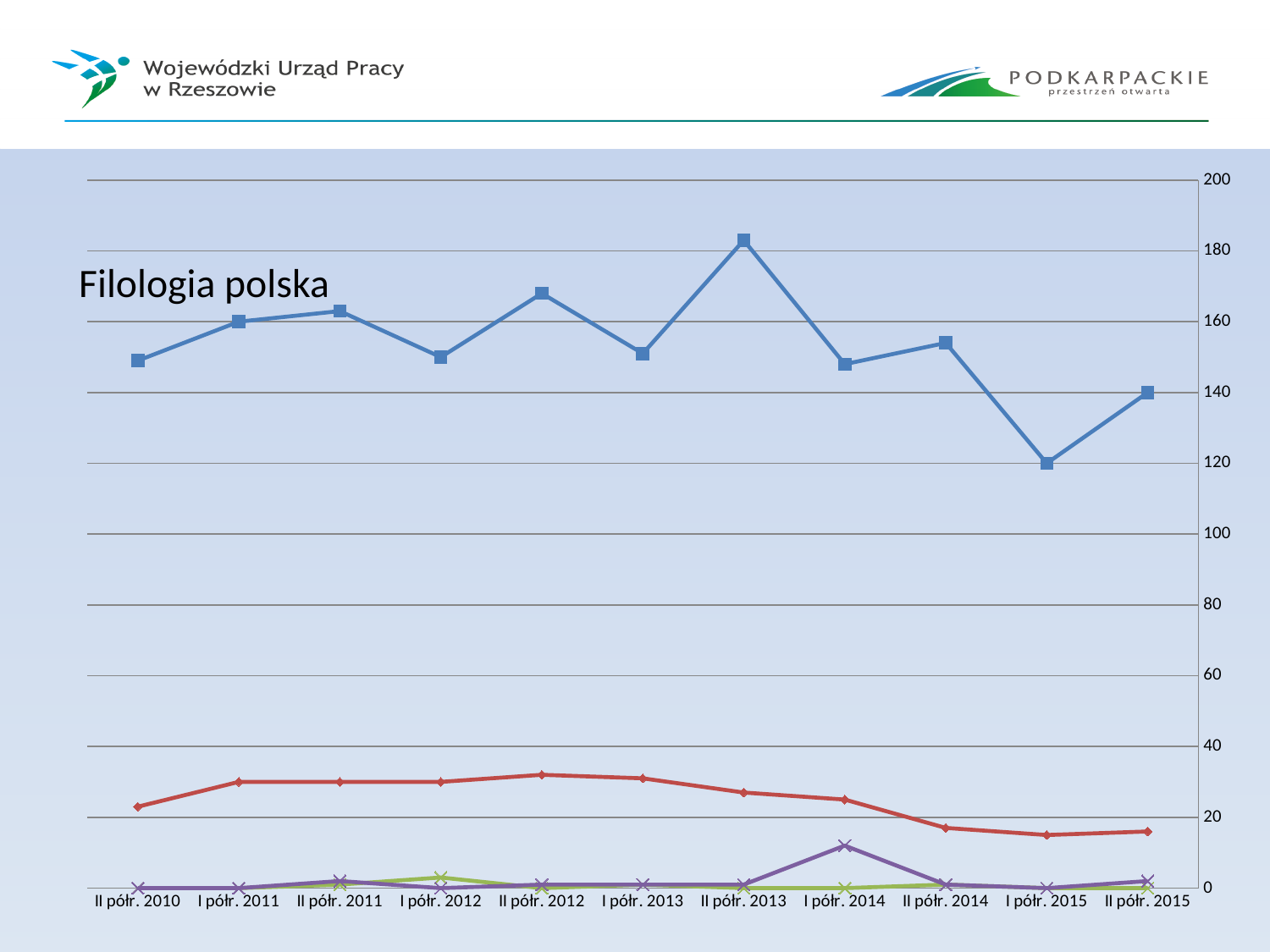
In which period does the purple line reach its highest value? I półr. 2014 Does the blue line rise or fall between II półr. 2014 and I półr. 2015? fall How many periods are shown along the x axis of the chart? 11 Is the value of the blue line for II półr. 2010 greater or less than 160? less Is the value of the blue line for II półr. 2012 greater or less than 160? greater In which period does the blue line reach its highest value? II półr. 2013 What kind of chart is shown on the slide? line chart In which period does the blue line reach its lowest value? I półr. 2015 Which is larger for the blue line: the value for II półr. 2013 or the value for I półr. 2014? II półr. 2013 How many lines are plotted on the chart? 4 What is the title of the chart? Filologia polska Is the value of the red line for I półr. 2015 greater or less than 20? less